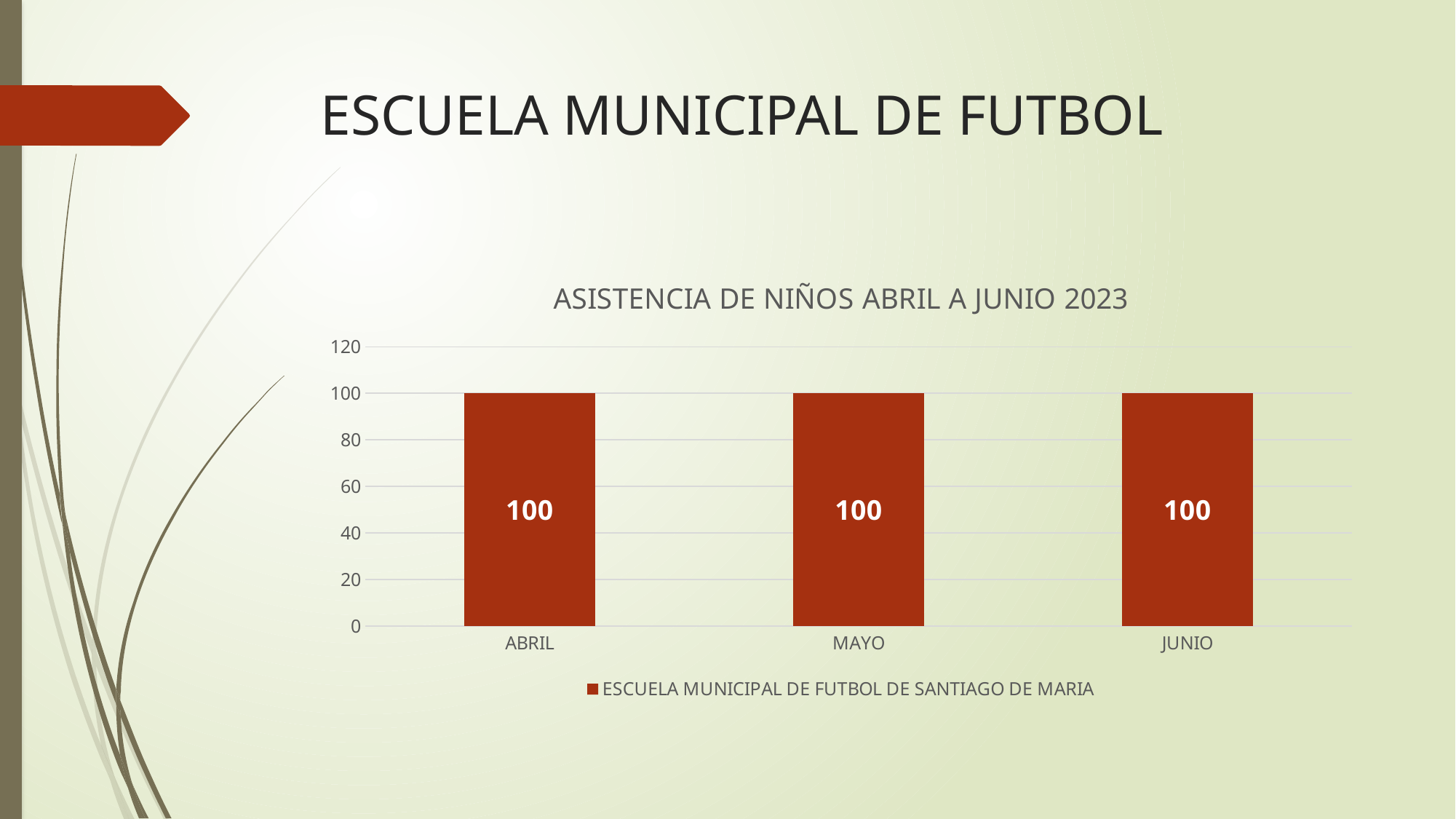
What series name does the legend show? ESCUELA MUNICIPAL DE FUTBOL DE SANTIAGO DE MARIA How many series does the legend list? 1 What is the difference between the values for ABRIL and JUNIO? 0 Is the value for MAYO greater or less than 80? greater What is the value for ABRIL? 100 What is the value for MAYO? 100 What is the title of the chart? ASISTENCIA DE NIÑOS ABRIL A JUNIO 2023 How many categories are shown on the x axis? 3 What kind of chart is shown? bar chart Is the value for JUNIO greater or less than 120? less What is the value for JUNIO? 100 Do the values rise, fall, or stay the same from ABRIL to JUNIO? stay the same